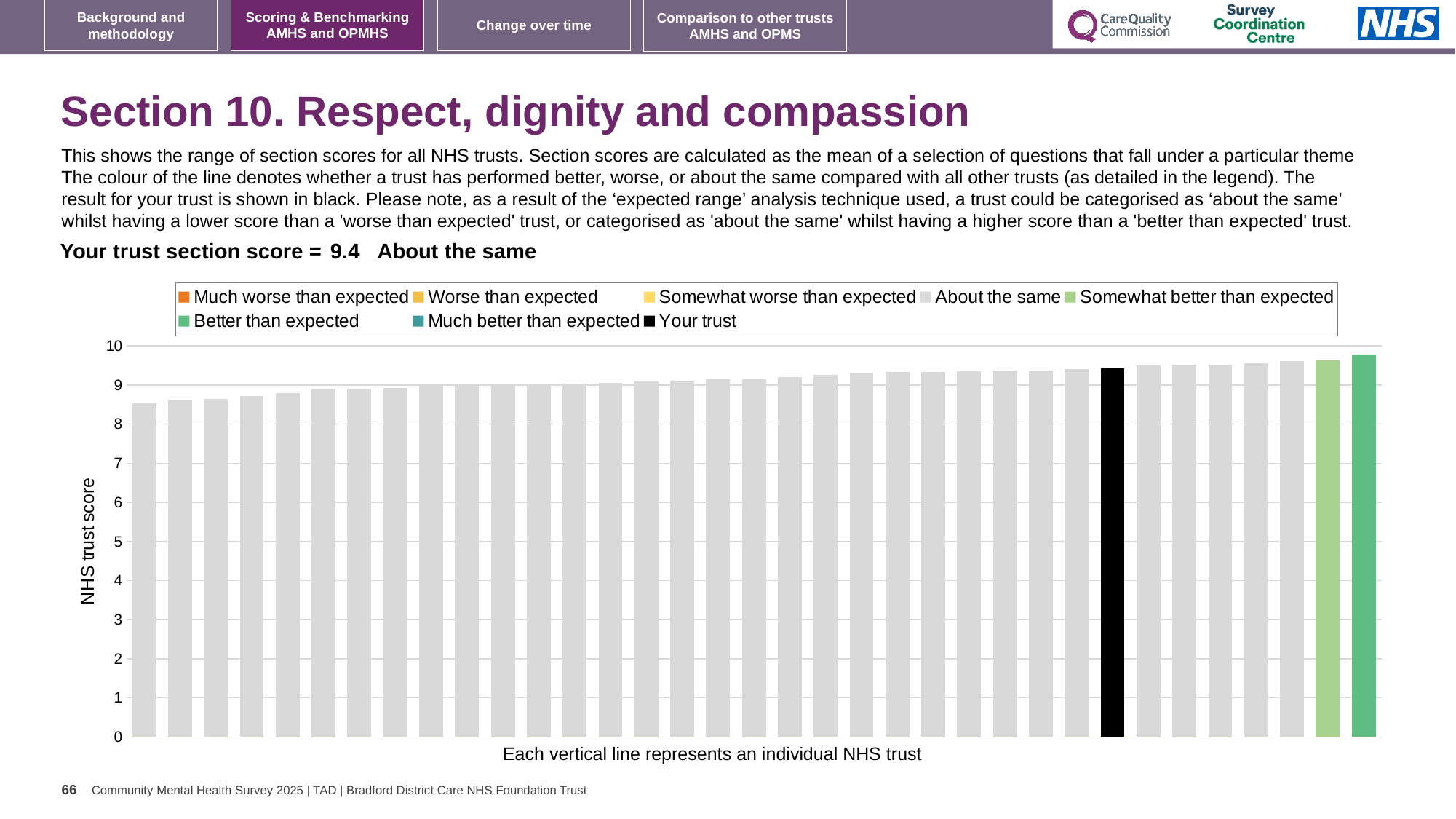
What kind of chart is shown on the slide? Bar chart Is the value of the leftmost (lowest) bar greater or less than 9? less Is the value of the rightmost (highest) bar greater or less than 9? greater What is the label on the vertical axis of the chart? NHS trust score How many entries does the chart legend list? 8 Which is larger: the value for your trust (black bar) or the value of the leftmost bar? Your trust What colour is the bar representing your trust? Black Is the value for your trust (the black bar) greater or less than 9? greater What is the section score for your trust? 9.4 Do the bar values rise or fall from left to right along the x axis? Rise Which benchmarking category is your trust placed in for this section? About the same Which legend category does the highest bar on the chart belong to? Better than expected